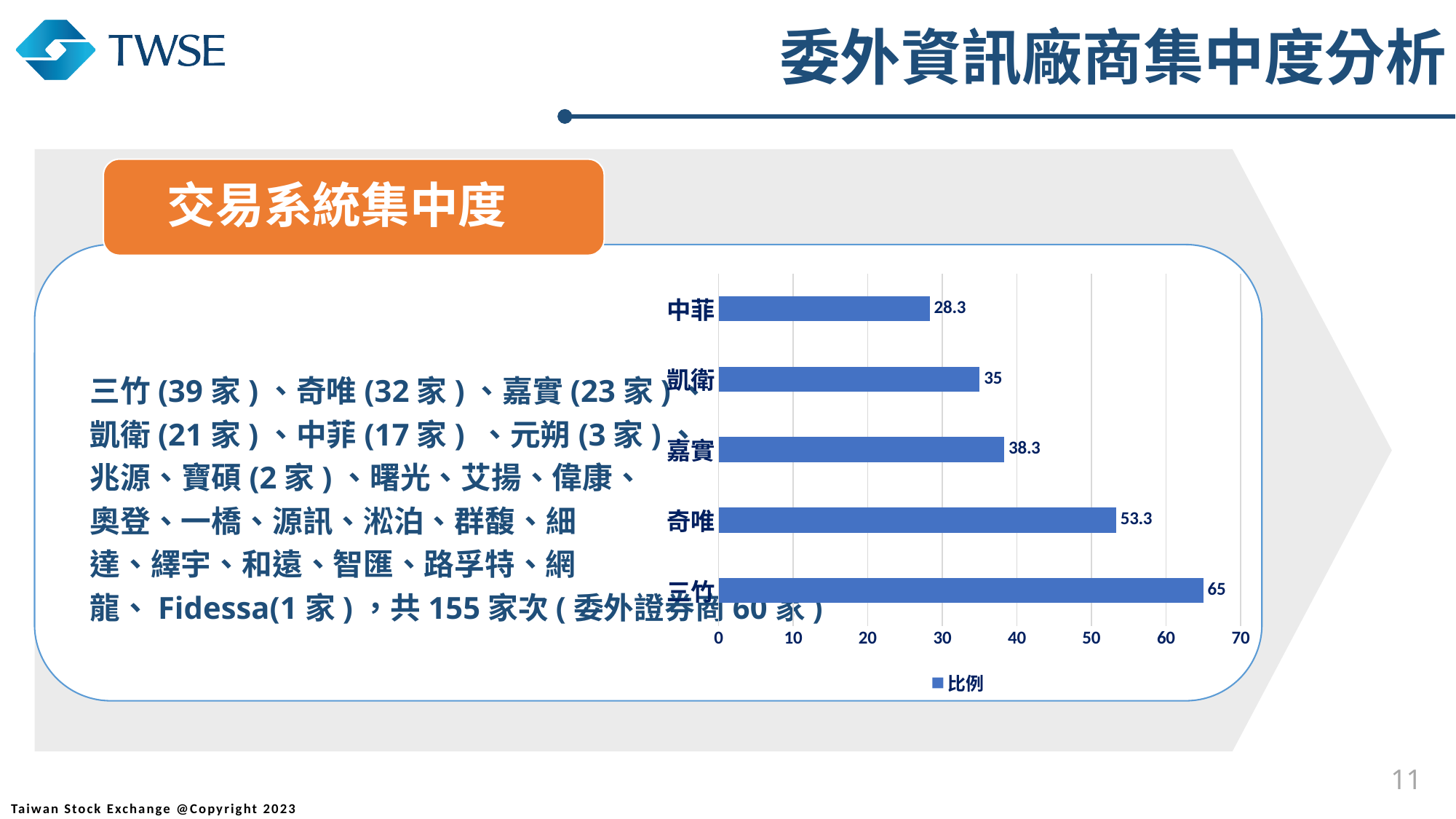
What is the value for 奇唯 in the chart? 53.3 What kind of chart is shown on the slide? bar chart What series name does the chart legend show? 比例 What is the value for 中菲 in the chart? 28.3 Which category has the highest value in the chart? 三竹 What is the value for 凱衛 in the chart? 35 What is the difference between the values for 三竹 and 奇唯? 11.7 What is the value for 嘉實 in the chart? 38.3 Which category has the lowest value in the chart? 中菲 How many categories are shown in the chart? 5 What is the value for 三竹 in the chart? 65 Which has a larger value, 嘉實 or 凱衛? 嘉實